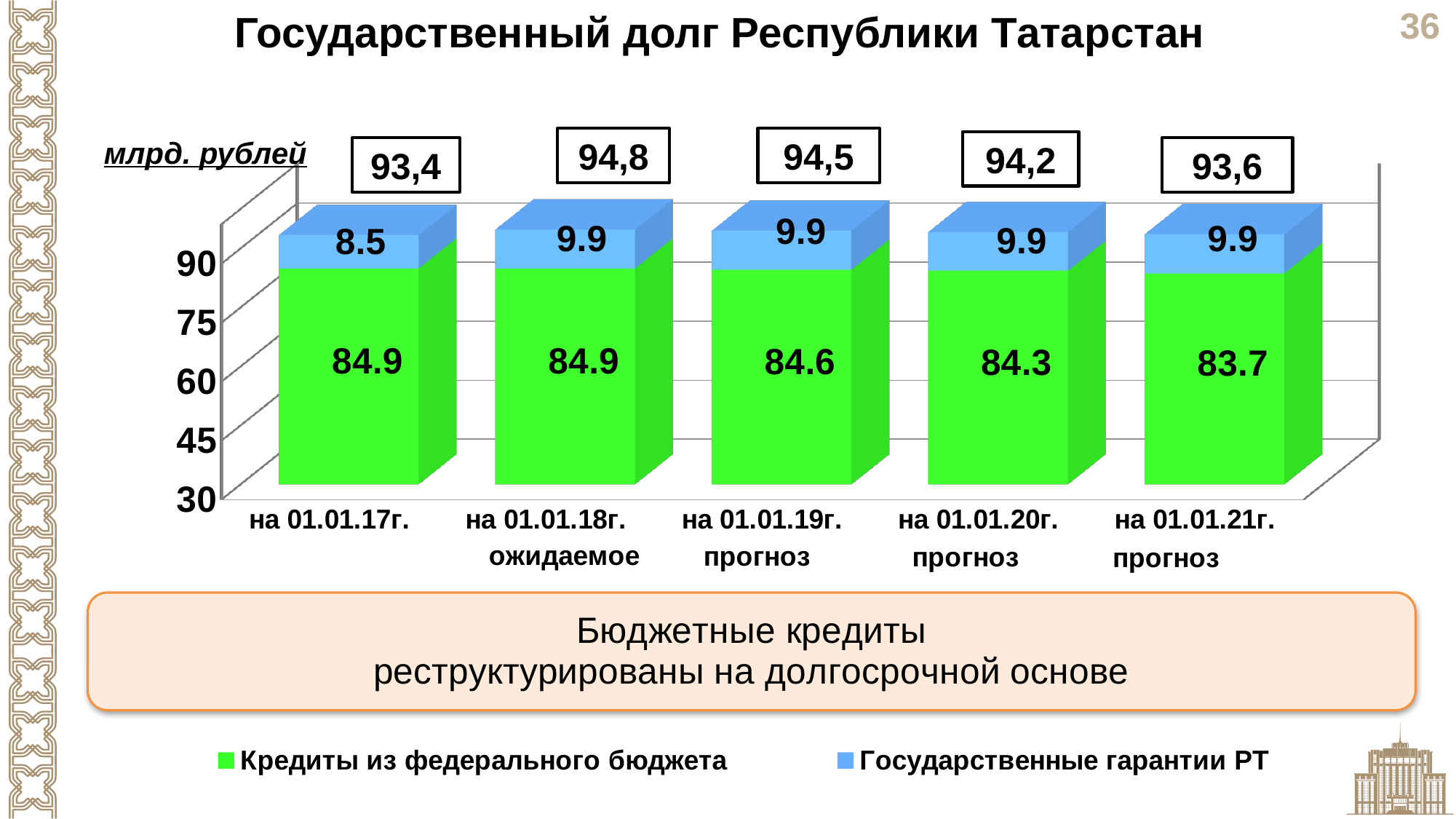
What is the value of 'Кредиты из федерального бюджета' for 'на 01.01.17г.'? 84.9 Which category has the lowest value for 'Кредиты из федерального бюджета'? на 01.01.21г. прогноз What is the value of 'Кредиты из федерального бюджета' for 'на 01.01.21г. прогноз'? 83.7 What is the value of 'Государственные гарантии РТ' for 'на 01.01.17г.'? 8.5 What is the difference between the 'Кредиты из федерального бюджета' values for 'на 01.01.18г. ожидаемое' and 'на 01.01.21г. прогноз'? 1.2 What kind of chart is shown on the slide? stacked bar chart How many categories are shown on the x axis? 5 How many series does the legend list? 2 Which is larger: 'Государственные гарантии РТ' for 'на 01.01.17г.' or for 'на 01.01.18г. ожидаемое'? на 01.01.18г. ожидаемое What is the total shown above the stacked bar for 'на 01.01.18г. ожидаемое'? 94,8 What is the value of 'Государственные гарантии РТ' for 'на 01.01.19г. прогноз'? 9.9 What is the total shown above the stacked bar for 'на 01.01.20г. прогноз'? 94,2